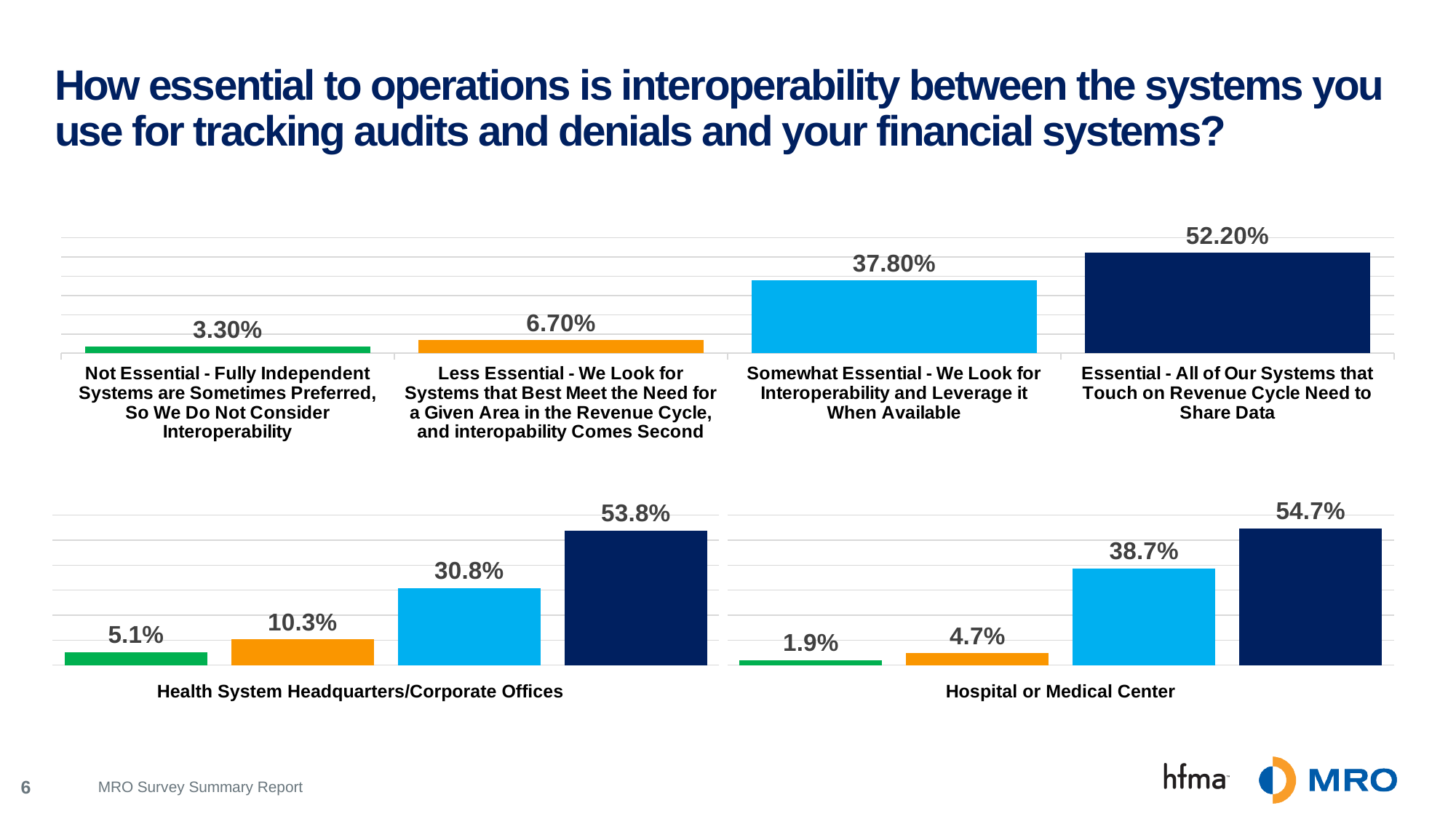
In the top chart, what percentage is shown for "Not Essential - Fully Independent Systems are Sometimes Preferred, So We Do Not Consider Interoperability"? 3.30% How many categories are shown in the top chart? 4 Which is larger: the tallest bar in the Health System Headquarters/Corporate Offices chart or the tallest bar in the Hospital or Medical Center chart? Hospital or Medical Center In the bottom-right chart (Hospital or Medical Center), what is the value of the shortest bar? 1.9% In the top chart, which category has the highest value? Essential - All of Our Systems that Touch on Revenue Cycle Need to Share Data In the bottom-left chart (Health System Headquarters/Corporate Offices), what is the value of the orange bar? 10.3% In the top chart, what is the difference between the "Essential" value and the "Somewhat Essential" value? 14.40% In the top chart, what percentage is shown for "Essential - All of Our Systems that Touch on Revenue Cycle Need to Share Data"? 52.20% In the bottom-left chart (Health System Headquarters/Corporate Offices), what is the value of the tallest bar? 53.8% What type of chart is the top chart? Bar chart In the top chart, which category has the lowest value? Not Essential - Fully Independent Systems are Sometimes Preferred, So We Do Not Consider Interoperability In the top chart, which is larger: the value for "Less Essential" or the value for "Somewhat Essential"? Somewhat Essential